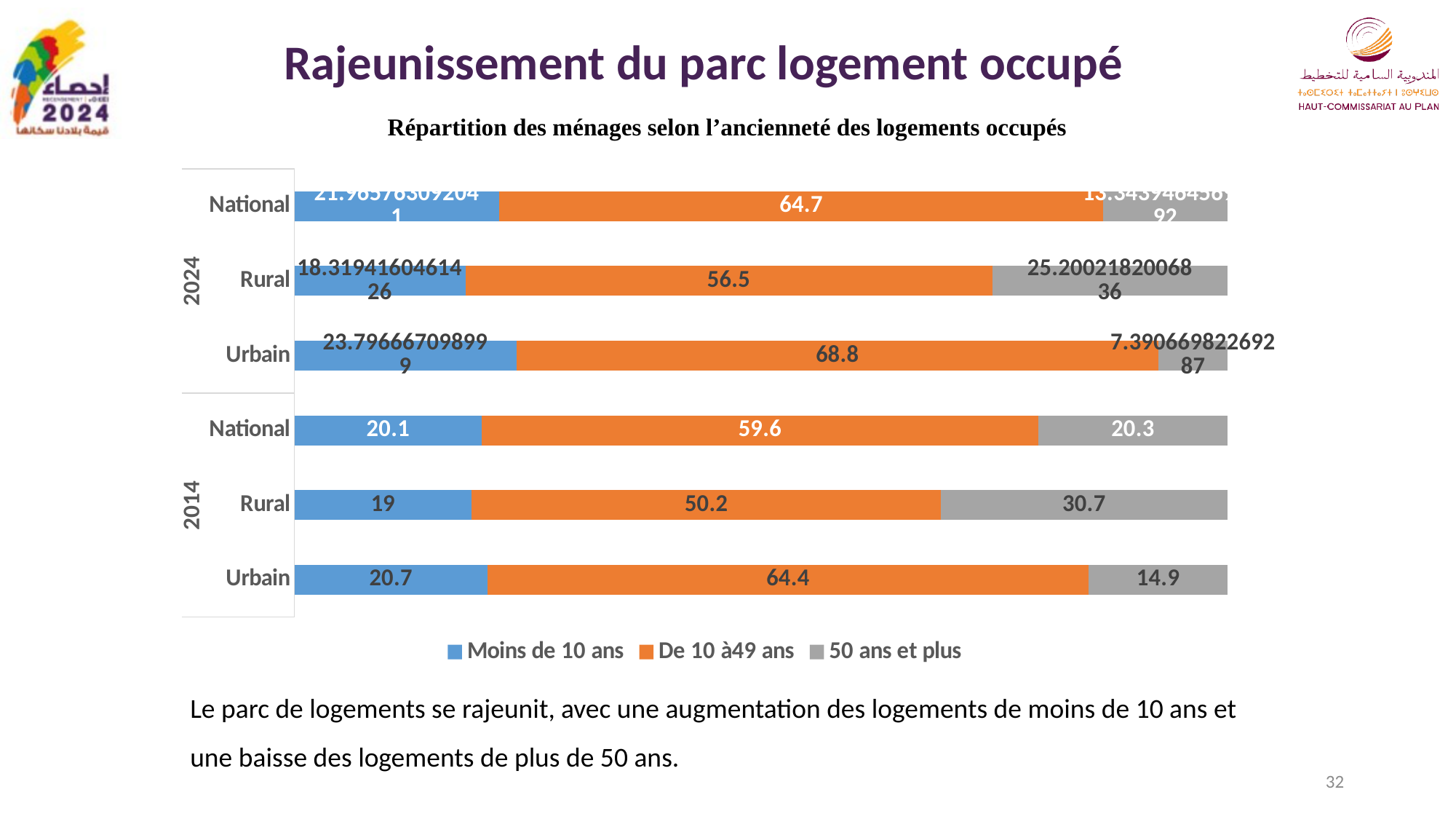
Which has a larger '50 ans et plus' value: Rural 2014 or Urbain 2014? Rural 2014 What kind of chart is shown on the slide? Stacked bar chart What is the difference between the 'De 10 à49 ans' values for Urbain 2014 and Rural 2014? 14.2 What is the value of the '50 ans et plus' segment for Rural in 2014? 30.7 Which bar has the lowest value for the 'De 10 à49 ans' series? Rural 2014 What is the total of the stacked bar for Urbain 2014? 100 What is the difference between the 'De 10 à49 ans' values for National 2024 and National 2014? 5.1 How many bars are shown in the chart? 6 What is the value of the 'De 10 à49 ans' segment for Urbain in 2024? 68.8 What is the value of the 'Moins de 10 ans' segment for National in 2014? 20.1 Which bar has the highest value for the 'De 10 à49 ans' series? Urbain 2024 How many series does the legend list? 3